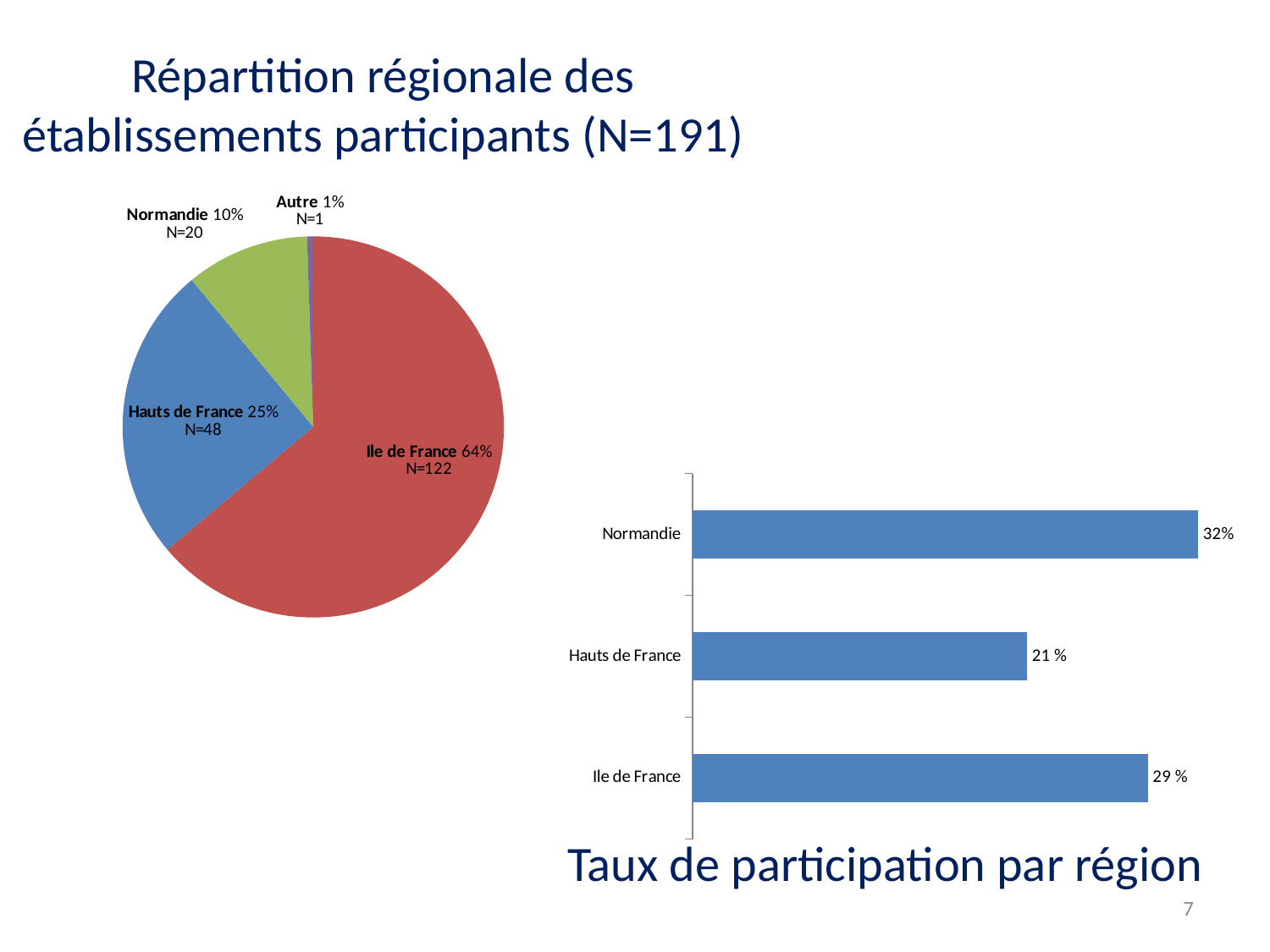
In the pie chart on the left, which category has the smallest slice? Autre In the bar chart 'Taux de participation par région', is the value for Ile de France larger or smaller than the value for Normandie? smaller In the bar chart 'Taux de participation par région', what is the value for Normandie? 32% In the bar chart 'Taux de participation par région', which region has the highest participation rate? Normandie In the pie chart on the left, which region has the largest slice? Ile de France In the pie chart on the left, what share of participating establishments is in Ile de France? 64% In the bar chart 'Taux de participation par région', what is the value for Hauts de France? 21 % In the pie chart on the left, how many establishments (N) are in Hauts de France? 48 What kind of chart is 'Taux de participation par région'? bar chart In the bar chart 'Taux de participation par région', which region has the lowest participation rate? Hauts de France In the pie chart on the left, what is the difference in N between Ile de France and Normandie? 102 In the pie chart on the left, how many slices are there? 4